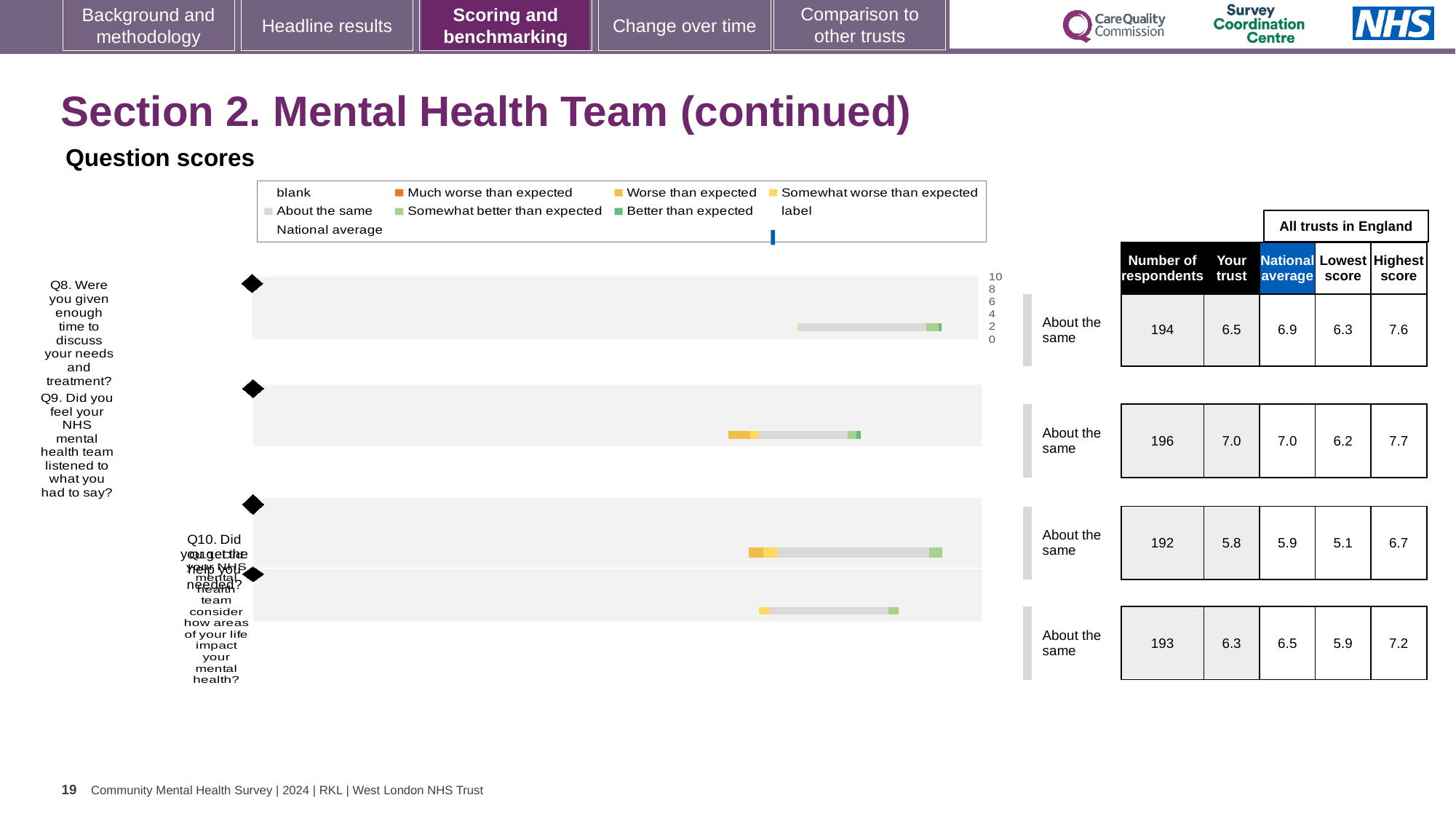
Which question has the highest 'Your trust' score in the table? Q9 What kind of chart is shown on the slide? bar chart In the table beside the chart, what is the number of respondents for Q9 (Did you feel your NHS mental health team listened to what you had to say?)? 196 Which is larger for Q11: the 'Your trust' score or the national average? national average In the table beside the chart, what is the highest score across all trusts in England for Q11? 7.2 What colour does the legend use for 'Better than expected'? green What colour does the legend use for 'Much worse than expected'? orange How many questions (bars) are plotted in the chart? 4 In the table beside the chart, what is the 'Your trust' score for Q8 (Were you given enough time to discuss your needs and treatment?)? 6.5 Which question has the lowest 'Your trust' score in the table? Q10 In the table beside the chart, what is the national average for Q10 (Did you get the help you needed?)? 5.9 What is the difference between the national average and the 'Your trust' score for Q8? 0.4